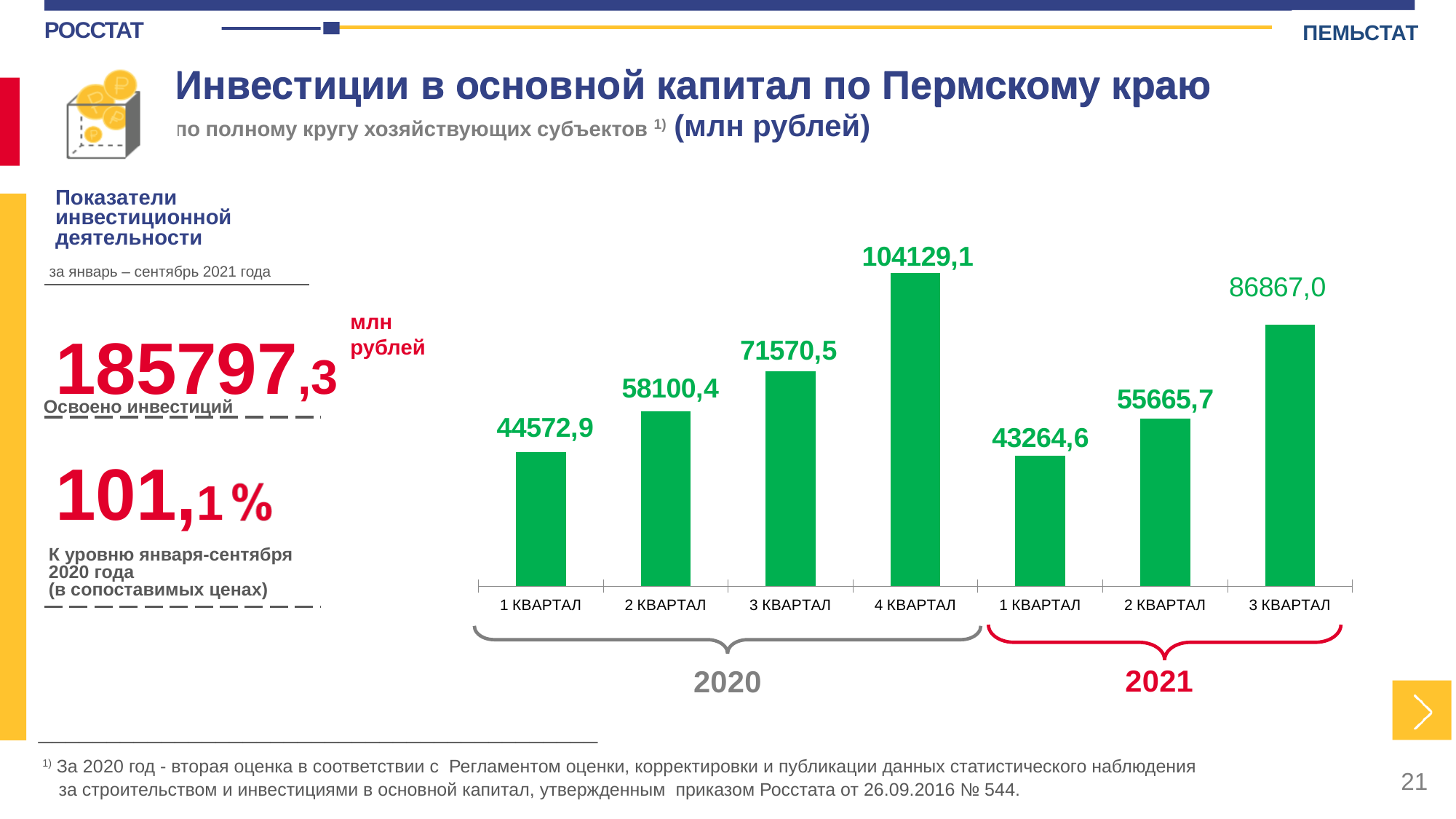
Which quarter has the highest value on the chart? 4 КВАРТАЛ 2020 Do the values rise or fall from 1 КВАРТАЛ to 4 КВАРТАЛ in 2020? Rise What is the value for 3 КВАРТАЛ 2021? 86867,0 How many bars are shown on the chart? 7 What is the value for 4 КВАРТАЛ 2020? 104129,1 What is the value for 1 КВАРТАЛ 2021? 43264,6 What is the difference between 4 КВАРТАЛ 2020 and 1 КВАРТАЛ 2020? 59556,2 What kind of chart is shown on the slide? Bar chart What is the difference between 3 КВАРТАЛ 2021 and 1 КВАРТАЛ 2021? 43602,4 Which is larger: 1 КВАРТАЛ 2020 or 1 КВАРТАЛ 2021? 1 КВАРТАЛ 2020 Which is larger: 3 КВАРТАЛ 2020 or 2 КВАРТАЛ 2021? 3 КВАРТАЛ 2020 Which quarter has the lowest value on the chart? 1 КВАРТАЛ 2021